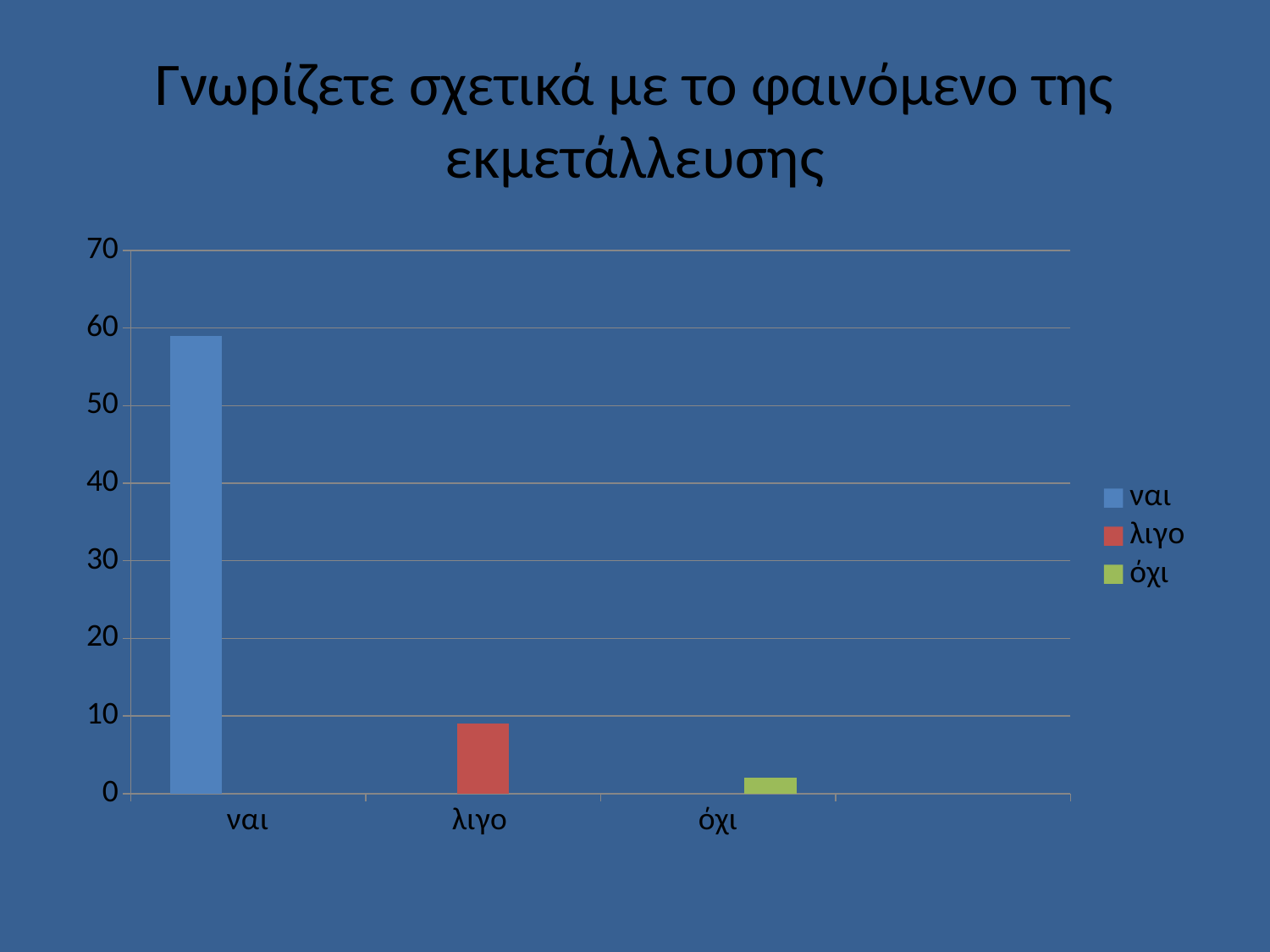
What colour is the bar for λιγο? red Which category has the highest bar? ναι What kind of chart is shown on the slide? bar chart How many categories are shown on the x axis of the chart? 3 Is the value for όχι greater or less than 10? less How many entries does the chart's legend list? 3 Which is larger, the value for ναι or the value for λιγο? ναι Which category has the lowest bar? όχι Which is larger, the value for λιγο or the value for όχι? λιγο Is the value for ναι greater or less than 50? greater Do the bar values rise or fall from left to right across the categories? fall